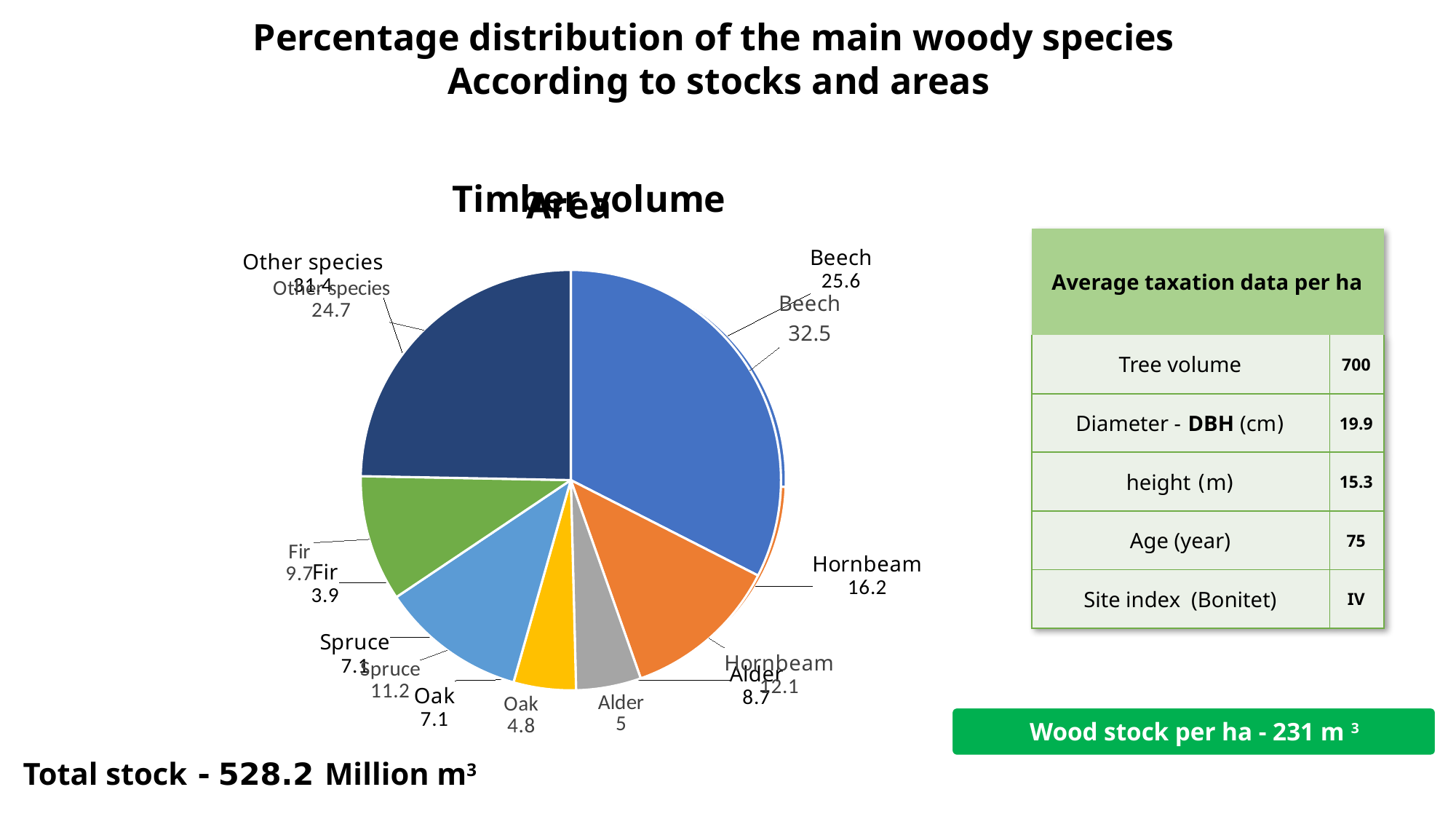
In the pie chart with the black data labels, which category has the largest value? Other species In the pie chart with the grey data labels, which species has the smallest slice? Oak How many slices (species categories) does the visible pie chart have? 7 In the pie chart with the black data labels, what is the value shown for Other species? 31.4 In the pie chart with the grey data labels, what is the difference between the Beech value and the Other species value? 7.8 In the pie chart with the grey data labels, what is the value shown for Beech? 32.5 What colour is the Beech slice in the visible pie chart? Blue In the pie chart with the grey data labels, which is larger, Spruce or Fir? Spruce In the pie chart with the black data labels, which species has the smallest value? Fir In the pie chart with the grey data labels, which species has the largest slice? Beech In the pie chart with the black data labels, what is the value shown for Hornbeam? 16.2 What type of chart is used to show the distribution of woody species? Pie chart